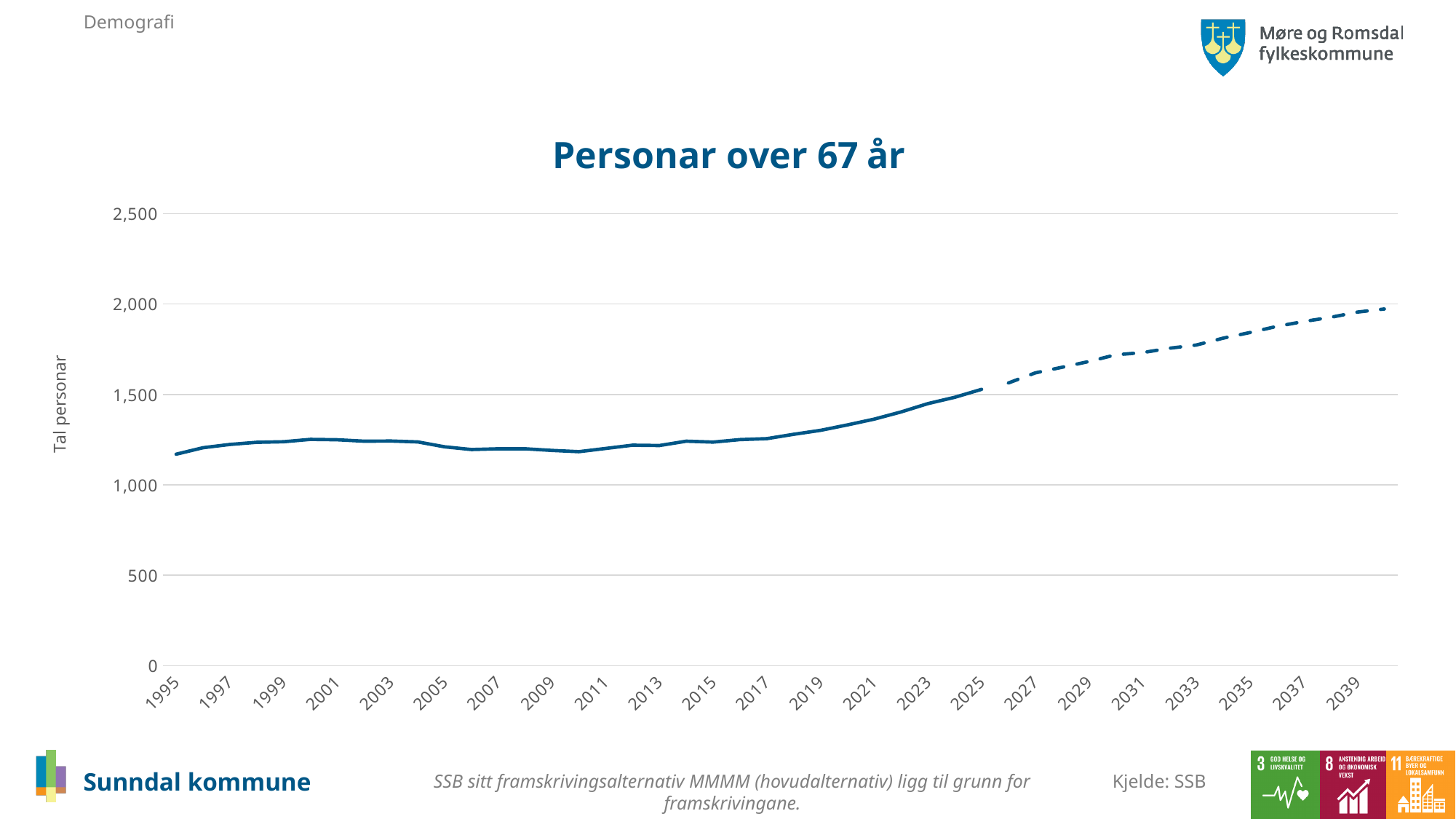
Does the line rise or fall between 2025 and 2039? rise Which year has the larger value, 2001 or 2010? 2001 What is the title of the chart? Personar over 67 år Is the value for 1995 greater or less than 1,500? less What is the label on the vertical axis of the chart? Tal personar What kind of chart is shown on the slide? line chart Is the value for 2007 greater or less than 1,000? greater Does the line reach its highest value at the beginning or at the end of the period shown? end Is the value for 2039 greater or less than 2,000? less Which year has the larger value, 1995 or 2025? 2025